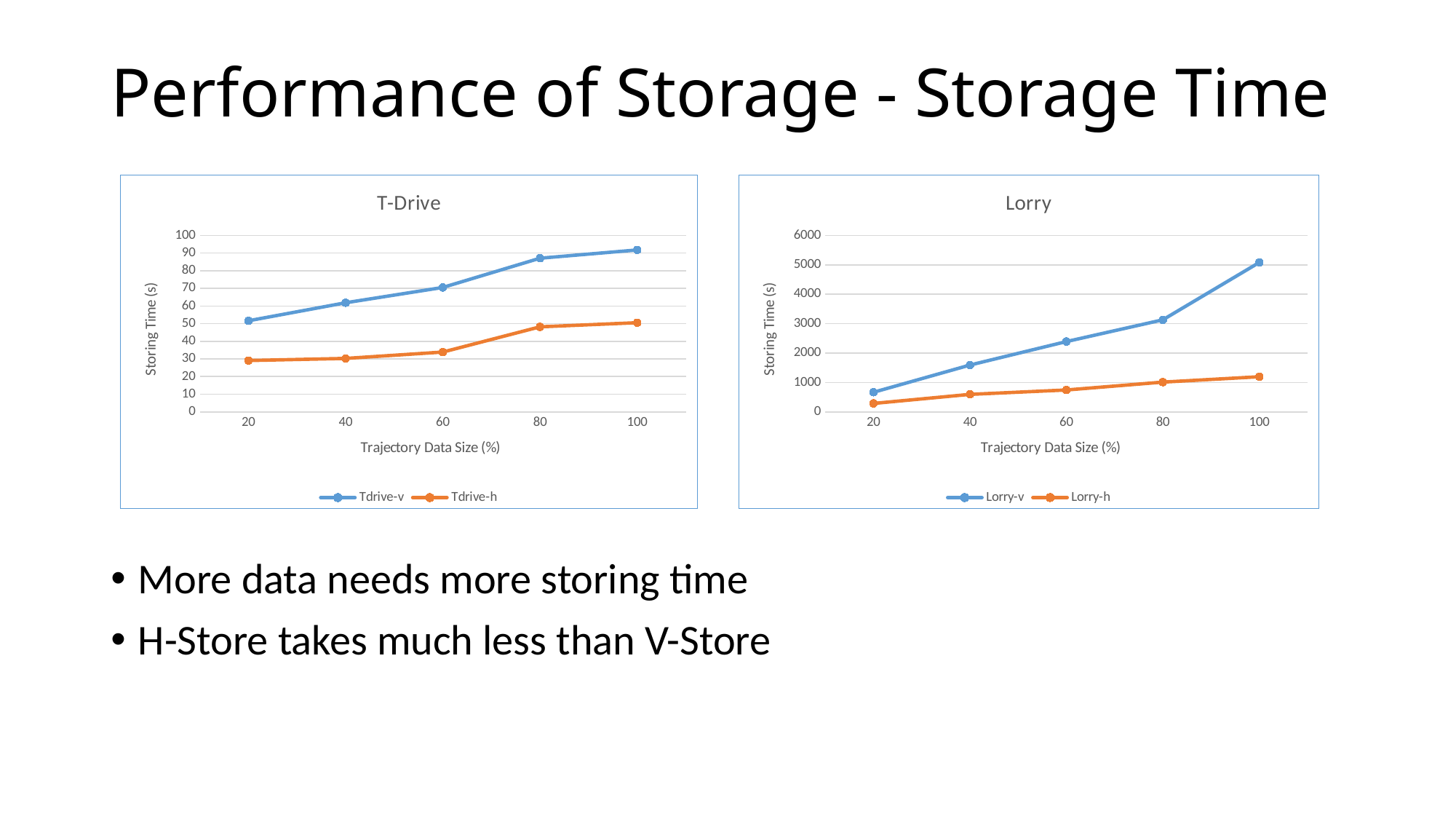
What type of chart is the T-Drive chart? line chart In the T-Drive chart, which series has the smaller value at 40%, Tdrive-v or Tdrive-h? Tdrive-h In the T-Drive chart, is the value for Tdrive-v at 80% greater or less than 80? greater In the T-Drive chart, is the value for Tdrive-h at 60% greater or less than 40? less What is the y-axis label of the Lorry chart? Storing Time (s) In the Lorry chart, is the value for Lorry-v at 100% greater or less than 4000? greater In the T-Drive chart, does the storing time for Tdrive-v rise or fall as the trajectory data size increases? rise In the Lorry chart, does the storing time for Lorry-h rise or fall as the trajectory data size increases? rise How many data points are plotted for the Tdrive-v series in the T-Drive chart? 5 In the Lorry chart, which series has the larger value at 100%, Lorry-v or Lorry-h? Lorry-v How many series does the legend of the Lorry chart list? 2